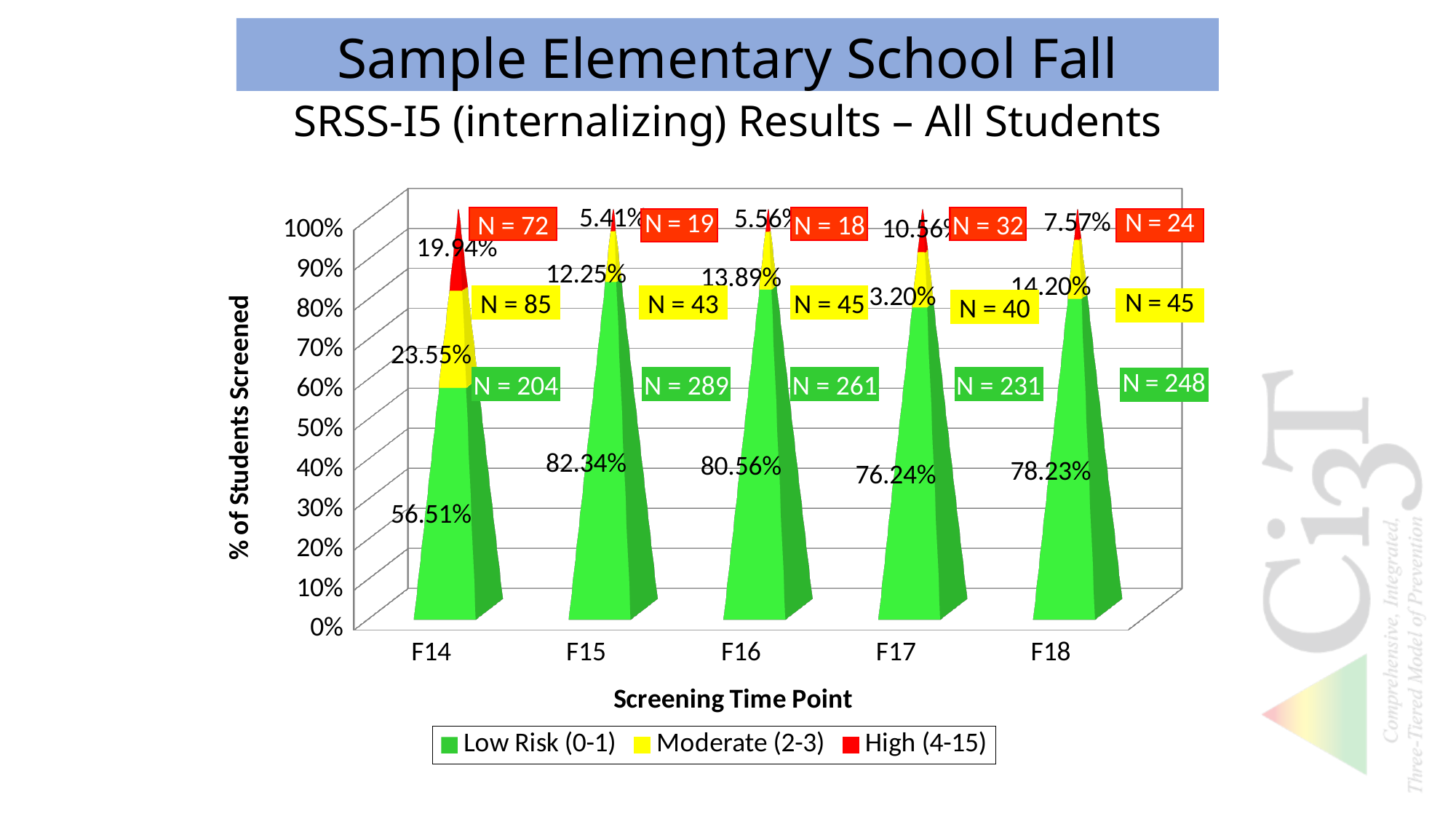
Which has a larger Moderate (2-3) percentage, F14 or F18? F14 Which screening time point has the lowest Low Risk (0-1) percentage? F14 How many series does the legend list? 3 What kind of chart is shown on the slide? Stacked bar chart What is the Moderate (2-3) percentage for F16? 13.89% What is the title of the x axis? Screening Time Point What is the Low Risk (0-1) percentage for F14? 56.51% What is the High (4-15) percentage for F14? 19.94% How many screening time points are shown on the x axis? 5 Which screening time point has the highest Low Risk (0-1) percentage? F15 What is the Low Risk (0-1) percentage for F15? 82.34% What is the difference between the Low Risk (0-1) percentages for F15 and F16? 1.78 percentage points